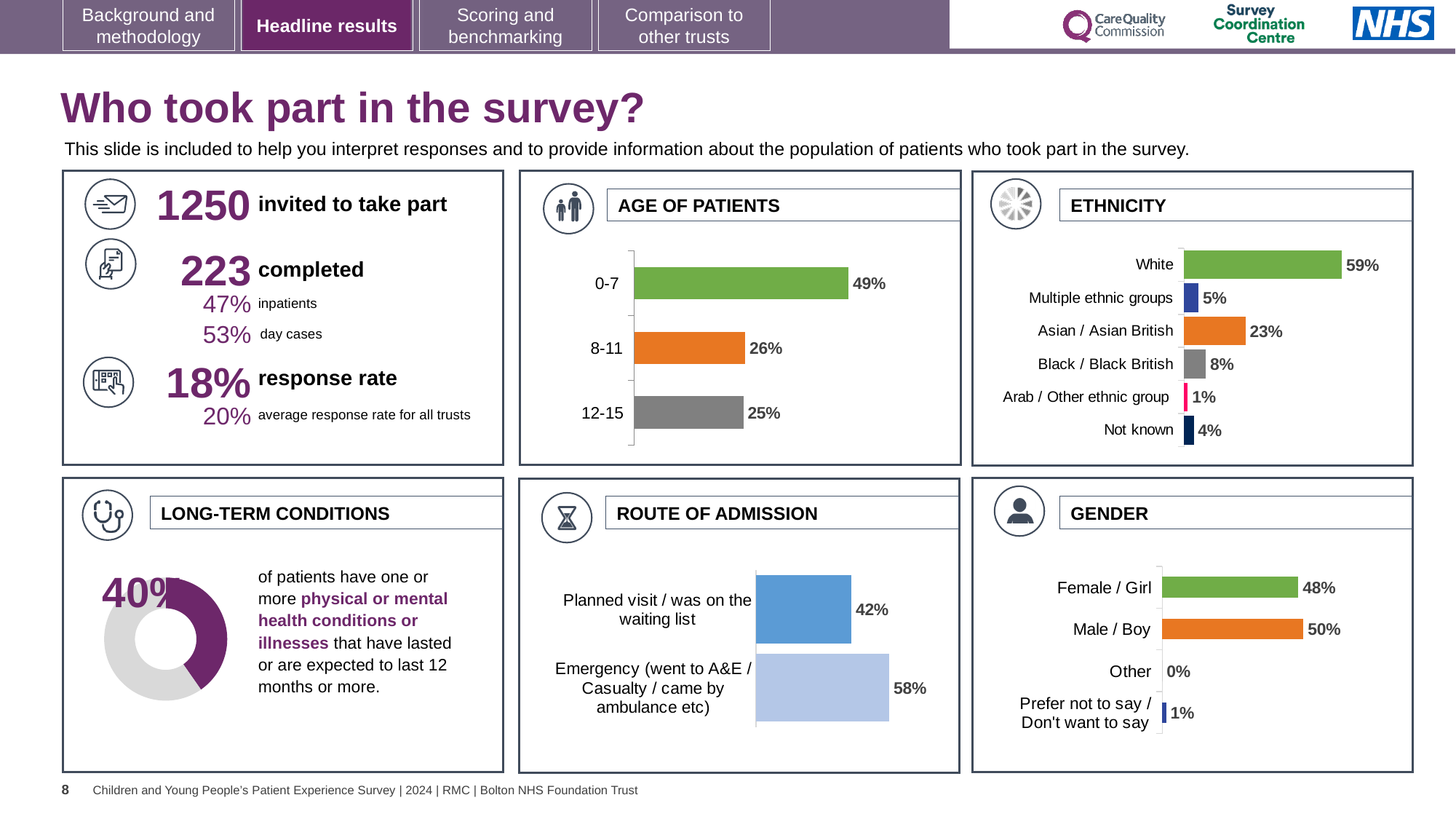
In the ETHNICITY chart, which category has the highest value? White In the GENDER chart, what is the difference between Male / Boy and Female / Girl? 2% How many categories are shown in the ETHNICITY chart? 6 In the ETHNICITY chart, what is the difference between White and Black / Black British? 51% In the GENDER chart, what is the value for Male / Boy? 50% In the AGE OF PATIENTS chart, what is the value for the 0-7 age group? 49% In the ROUTE OF ADMISSION chart, what is the value for Emergency (went to A&E / Casualty / came by ambulance etc)? 58% In the AGE OF PATIENTS chart, which age group has the lowest value? 12-15 What kind of chart is used in the LONG-TERM CONDITIONS panel? Donut chart In the ROUTE OF ADMISSION chart, which is larger: Planned visit / was on the waiting list or Emergency? Emergency In the ETHNICITY chart, what is the value for Asian / Asian British? 23% In the LONG-TERM CONDITIONS chart, what share of patients have one or more long-term conditions? 40%